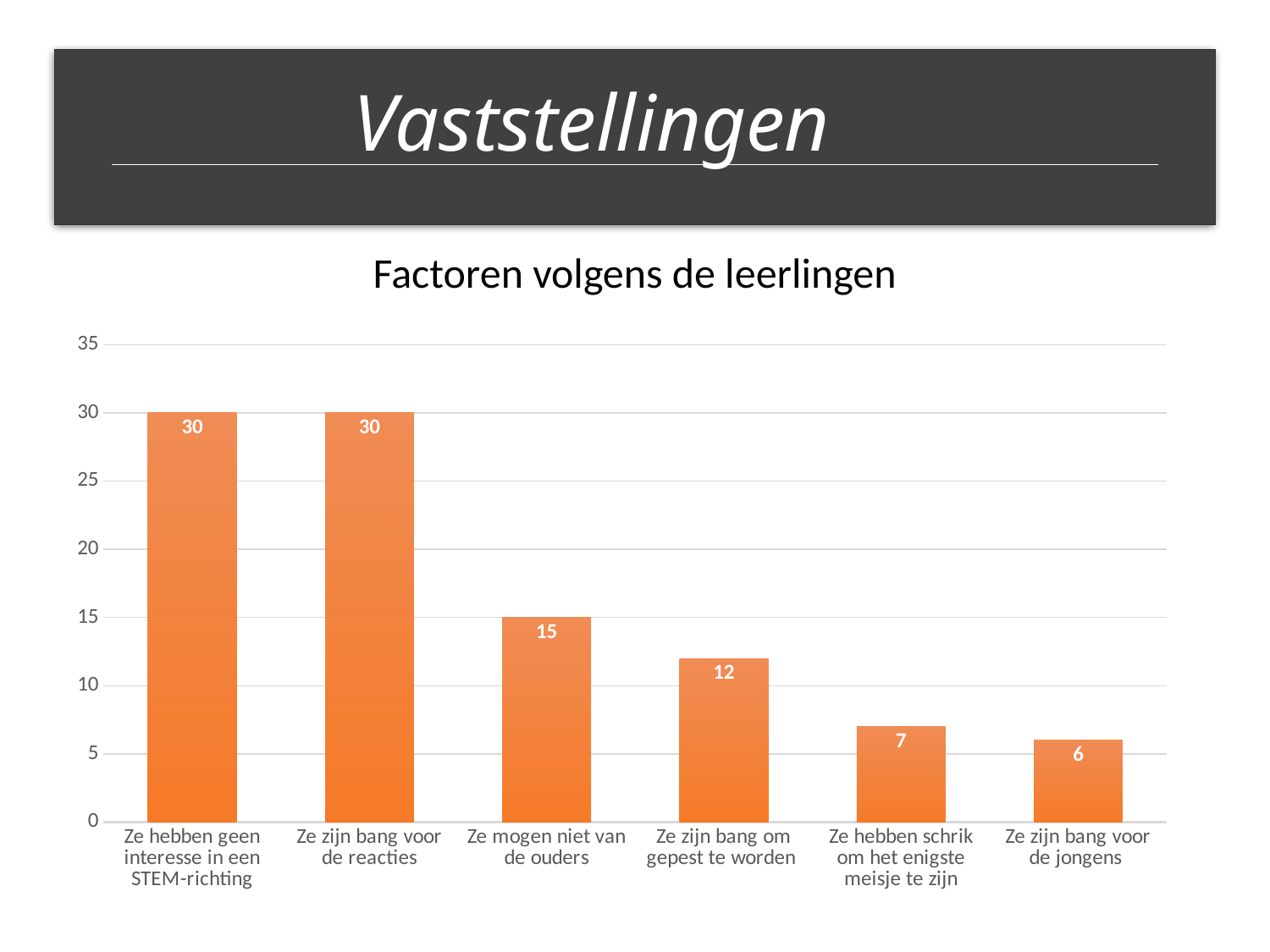
What is the value for "Ze mogen niet van de ouders"? 15 What is the value for "Ze zijn bang voor de jongens"? 6 What is the difference between the values for "Ze hebben geen interesse in een STEM-richting" and "Ze mogen niet van de ouders"? 15 Is the value for "Ze zijn bang voor de reacties" greater or less than 25? greater What kind of chart is shown on the slide? bar chart What is the difference between the values for "Ze zijn bang om gepest te worden" and "Ze zijn bang voor de jongens"? 6 What is the value for "Ze hebben schrik om het enigste meisje te zijn"? 7 What is the value for "Ze zijn bang om gepest te worden"? 12 What is the title of the chart? Factoren volgens de leerlingen Which is larger: the value for "Ze mogen niet van de ouders" or the value for "Ze zijn bang om gepest te worden"? Ze mogen niet van de ouders Which category has the lowest value? Ze zijn bang voor de jongens How many categories are shown in the chart? 6